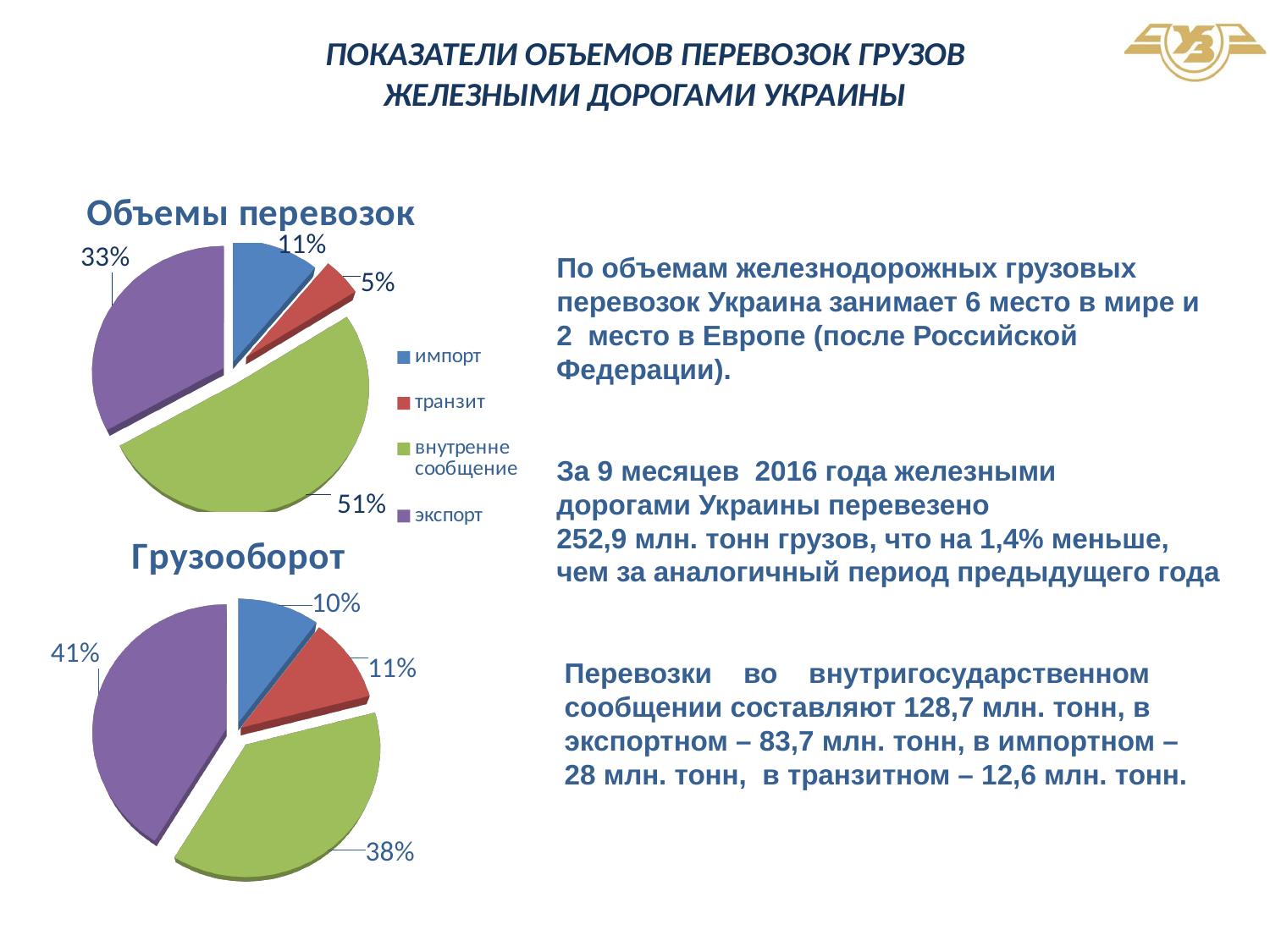
In the 'Объемы перевозок' pie chart, what share does 'транзит' have? 5% What type of chart is 'Объемы перевозок'? Pie chart In the 'Объемы перевозок' pie chart, which category has the smallest share? транзит How many entries does the legend of the 'Объемы перевозок' chart list? 4 In the 'Объемы перевозок' pie chart, what share does 'экспорт' have? 33% In the 'Объемы перевозок' pie chart, what is the difference between the shares of 'экспорт' and 'импорт'? 22% In the 'Объемы перевозок' pie chart, which category has the largest share? внутренне сообщение In the 'Грузооборот' pie chart, what is the share of the green slice? 38% In the 'Объемы перевозок' pie chart, what share does 'внутренне сообщение' have? 51% In the 'Грузооборот' pie chart, what is the share of the largest slice (purple)? 41% In the 'Грузооборот' pie chart, what is the share of the blue slice? 10% How many slices does the 'Грузооборот' pie chart have? 4